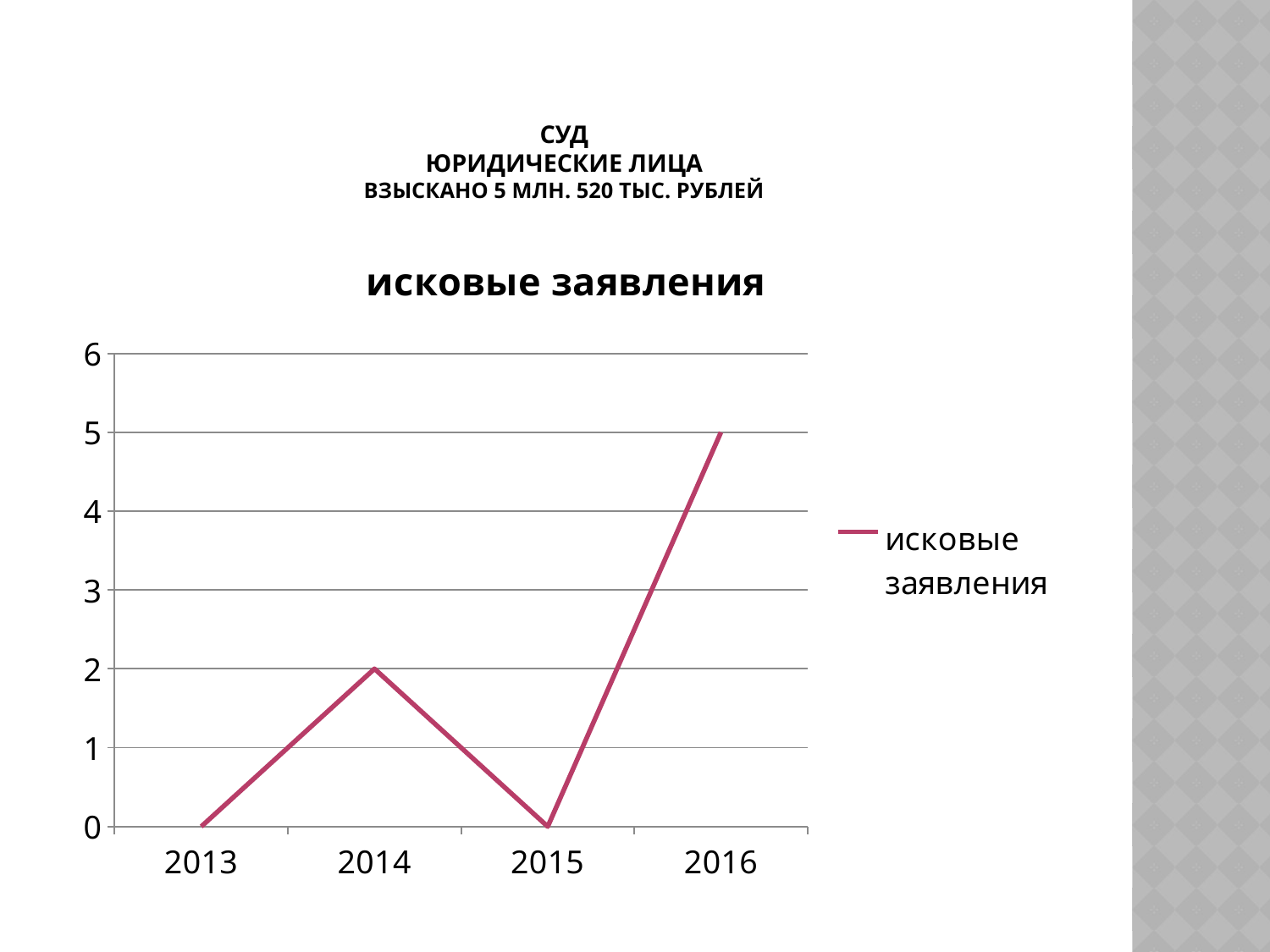
Which is larger, the value for 2014 or the value for 2015? 2014 Does the value rise or fall from 2015 to 2016? rise What is the title of the chart? исковые заявления Is the value for 2016 greater or less than 4? greater What is the value for 2014? 2 What kind of chart is shown on the slide? line chart How many years are shown on the x axis? 4 What is the value for 2013? 0 What is the difference between the values for 2016 and 2014? 3 How many series does the legend list? 1 Which year has the highest value? 2016 What is the value for 2016? 5